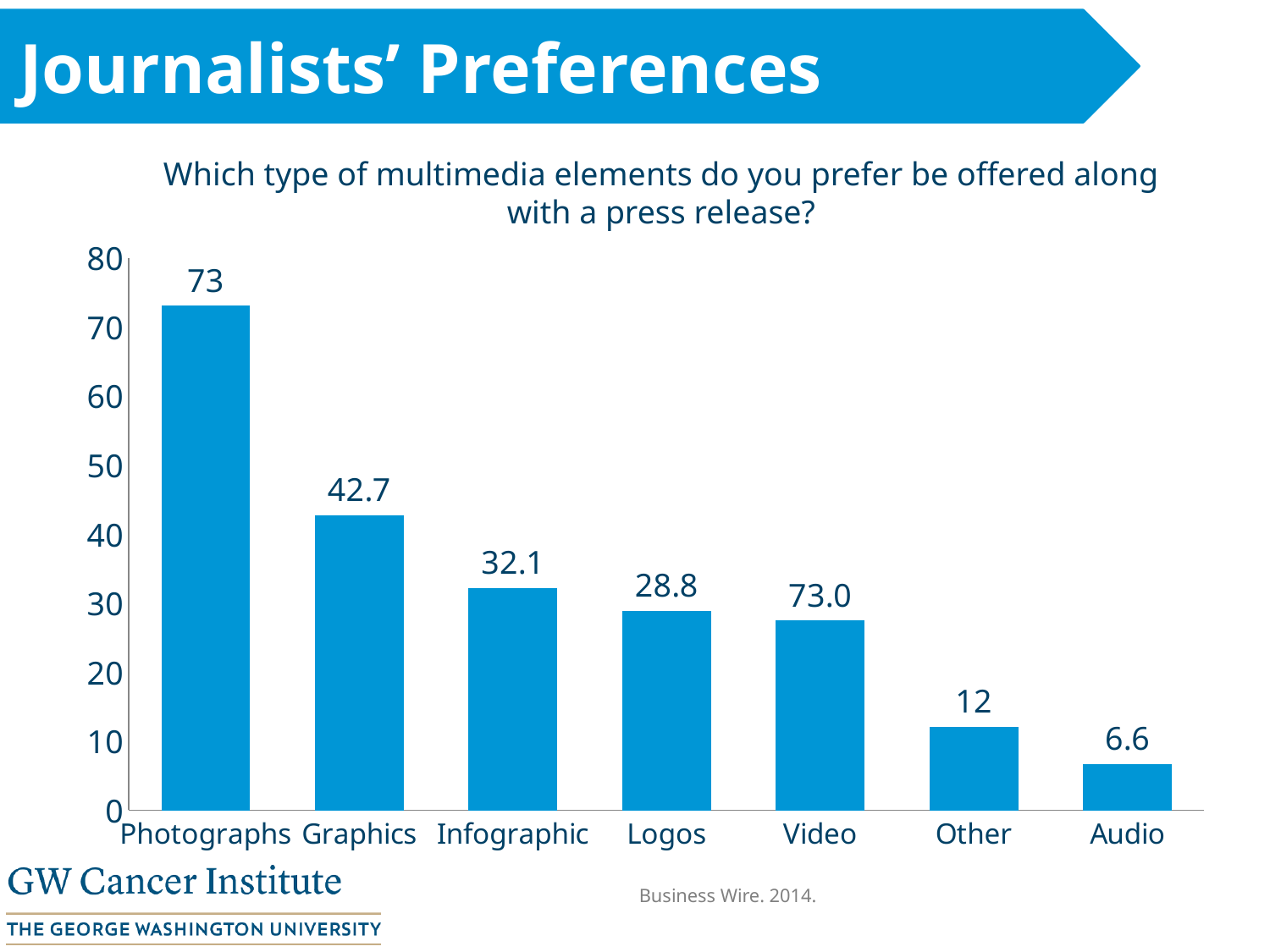
Which is larger, the value for Logos or the value for Other? Logos What value is shown for Photographs? 73 What value is shown for Audio? 6.6 What question is the chart titled with? Which type of multimedia elements do you prefer be offered along with a press release? Which category has the lowest value? Audio Is the value for Video greater or less than 30? less What value is shown for Infographic? 32.1 What kind of chart is shown on the slide? bar chart How many categories are shown on the x axis? 7 What value is shown for Logos? 28.8 What value is shown for Graphics? 42.7 What is the difference between the values for Graphics and Infographic? 10.6